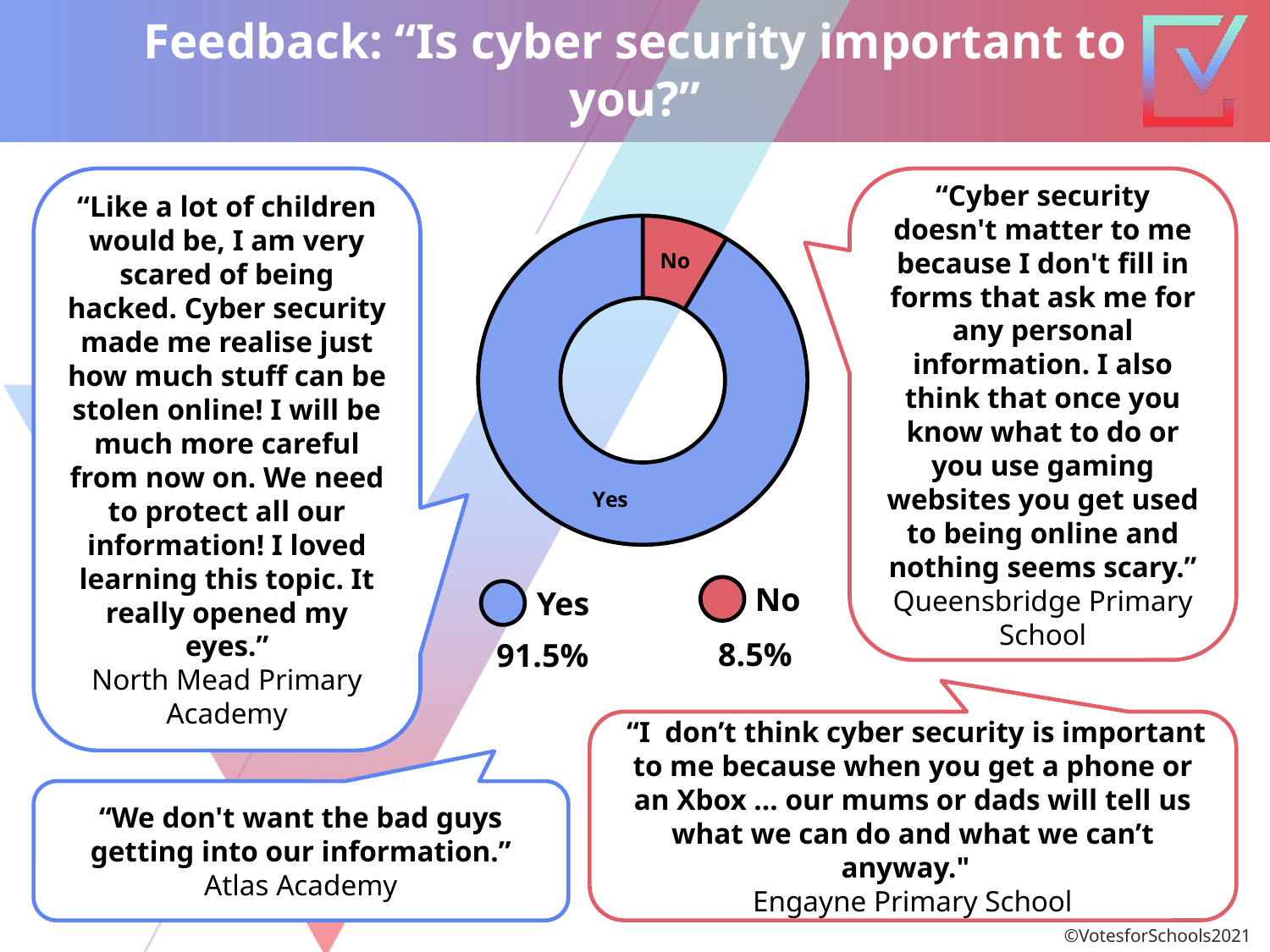
What is the difference in percentage points between the Yes and No shares? 83 What is the total of the Yes and No percentages shown? 100% Which is larger, the Yes share or the No share? Yes What kind of chart is shown on the slide? Pie chart (doughnut) What colour represents the Yes response in the chart? Blue Which response has the smallest share of the chart? No What percentage of respondents answered Yes? 91.5% What colour represents the No response in the chart? Red What percentage of respondents answered No? 8.5% Which response has the largest share of the chart? Yes How many categories does the chart show? 2